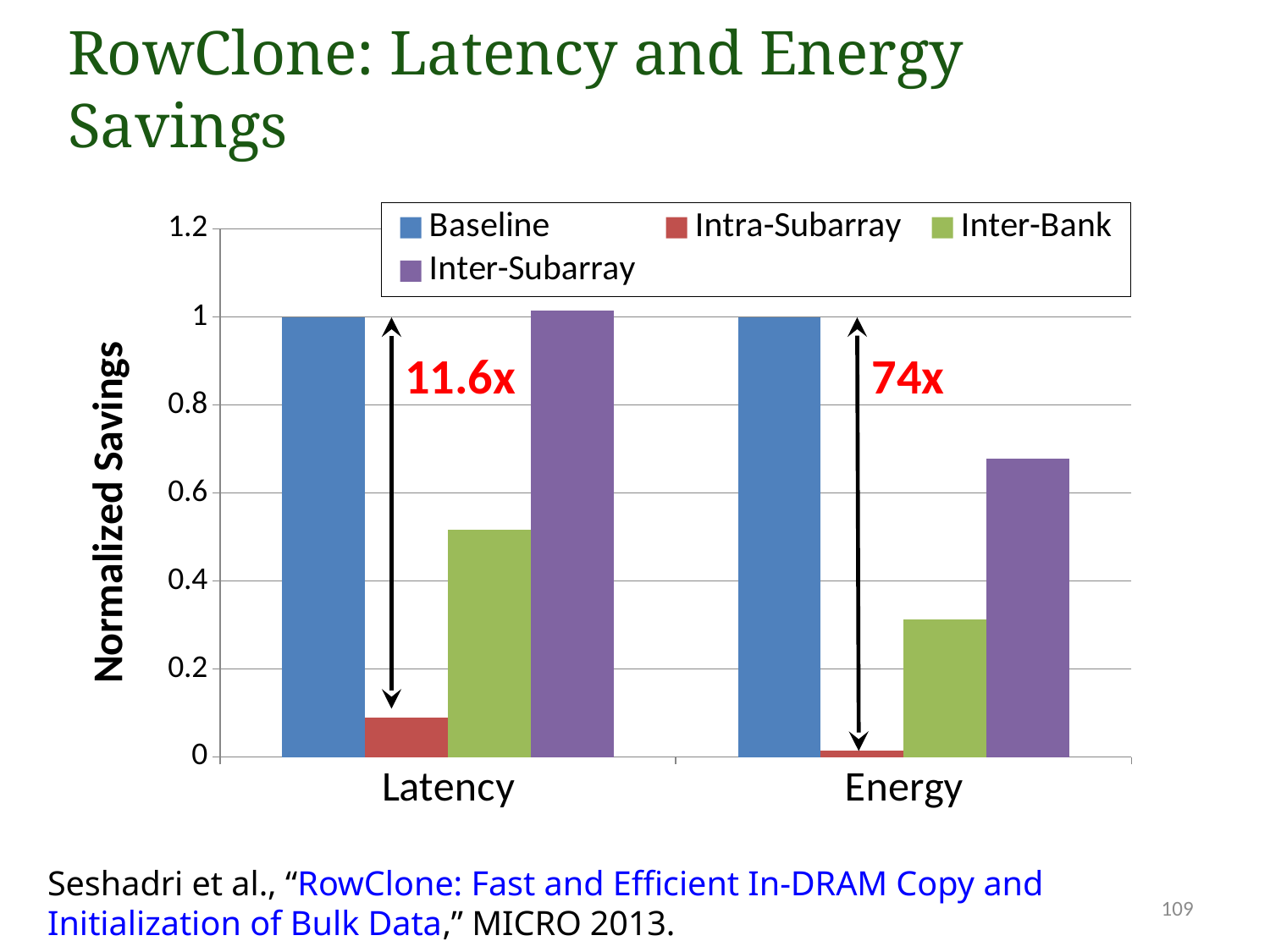
What kind of chart is shown on the slide? bar chart Is the Inter-Subarray value for Energy greater or less than 0.6? greater Which series has the lowest value for Energy? Intra-Subarray Is the Intra-Subarray value for Latency greater or less than 0.2? less For Latency, which is larger: Inter-Bank or Inter-Subarray? Inter-Subarray What is the title of the y axis? Normalized Savings How many series does the legend list? 4 How many categories are shown on the x axis? 2 What is the Baseline value for Energy? 1 Is the Inter-Bank value for Latency greater or less than 0.4? greater What improvement factor is annotated above the Energy bars? 74x What is the Baseline value for Latency? 1